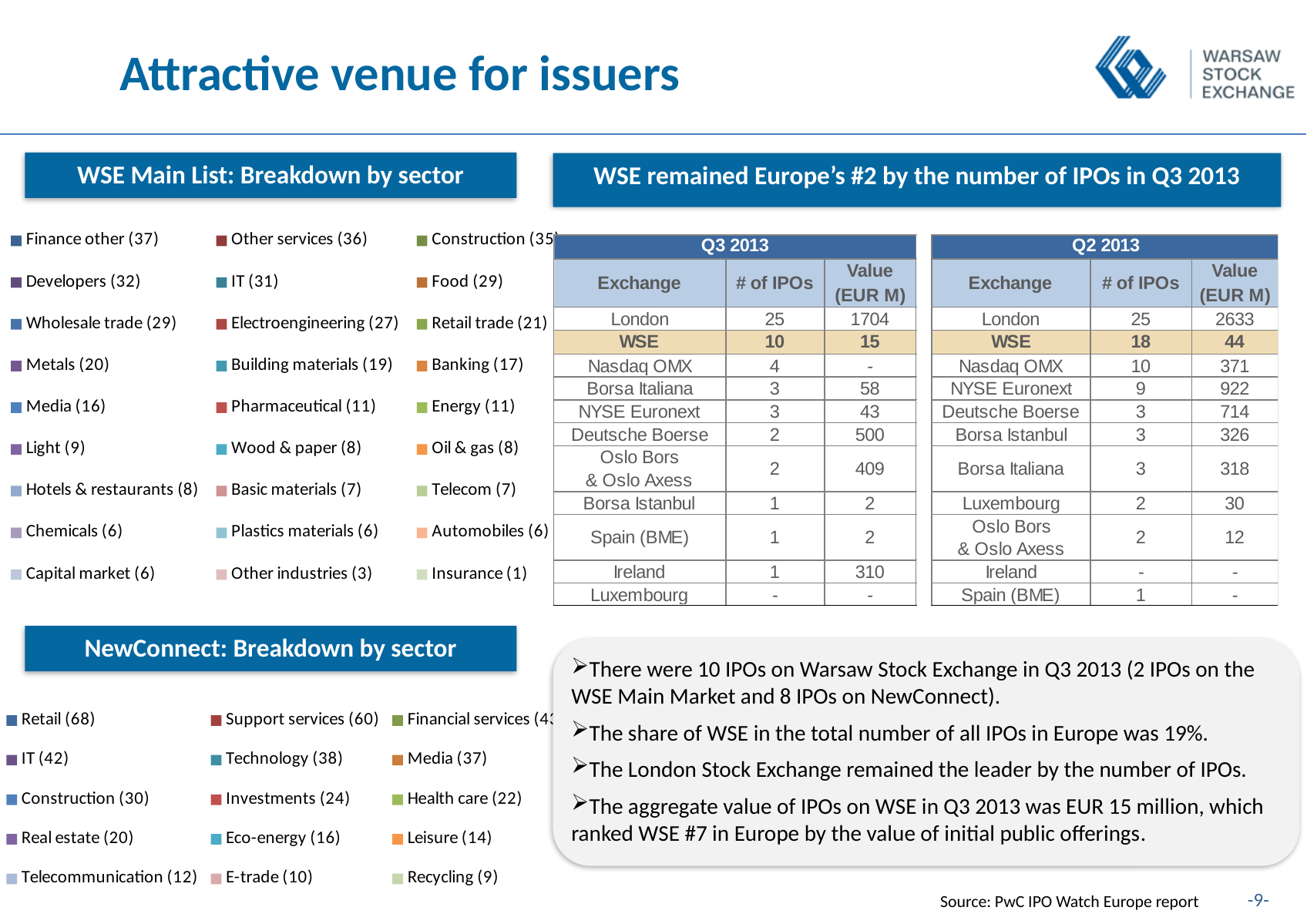
In the 'NewConnect: Breakdown by sector' chart, what value is shown for Retail? 68 In the 'NewConnect: Breakdown by sector' chart, which is larger, Technology or Media? Technology In the 'WSE Main List: Breakdown by sector' chart, which is larger, IT or Food? IT In the 'WSE Main List: Breakdown by sector' chart, what value is shown for Finance other? 37 In the 'WSE Main List: Breakdown by sector' chart, what is the difference between Developers and Metals? 12 In the 'NewConnect: Breakdown by sector' chart, what value is shown for Health care? 22 In the 'WSE Main List: Breakdown by sector' chart, which sector has the highest value? Finance other In the 'WSE Main List: Breakdown by sector' chart, what value is shown for Banking? 17 In the 'NewConnect: Breakdown by sector' chart, what is the difference between Retail and Support services? 8 In the 'WSE Main List: Breakdown by sector' chart, which sector has the lowest value? Insurance In the 'NewConnect: Breakdown by sector' chart, which sector has the lowest value? Recycling How many sectors are listed in the 'WSE Main List: Breakdown by sector' chart legend? 27